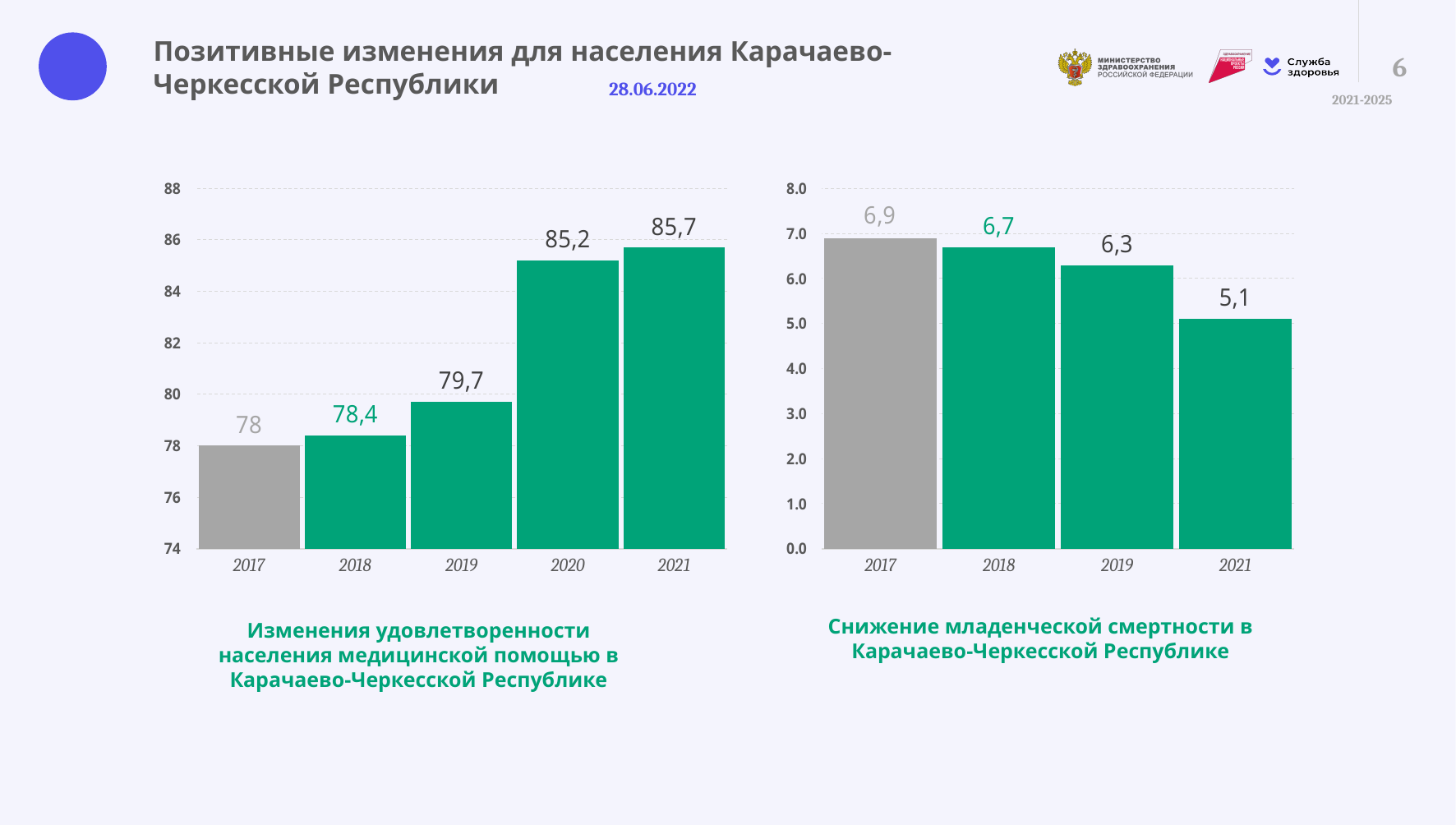
In the left chart (Изменения удовлетворенности населения медицинской помощью), how many years are shown? 5 In the left chart (Изменения удовлетворенности населения медицинской помощью), what is the value for 2019? 79,7 In the right chart (Снижение младенческой смертности), do the values rise or fall from 2017 to 2021? fall In the left chart (Изменения удовлетворенности населения медицинской помощью), what is the difference between the 2021 and 2017 values? 7,7 In the left chart (Изменения удовлетворенности населения медицинской помощью), what is the value for 2017? 78 In the right chart (Снижение младенческой смертности), what is the value for 2018? 6,7 In the left chart (Изменения удовлетворенности населения медицинской помощью), which year has the highest value? 2021 What type of chart is the right chart (Снижение младенческой смертности)? bar chart In the left chart (Изменения удовлетворенности населения медицинской помощью), do the values rise or fall from 2017 to 2021? rise In the right chart (Снижение младенческой смертности), which year has the lowest value? 2021 In the right chart (Снижение младенческой смертности), what is the difference between the 2017 and 2019 values? 0,6 In the right chart (Снижение младенческой смертности), what is the value for 2021? 5,1